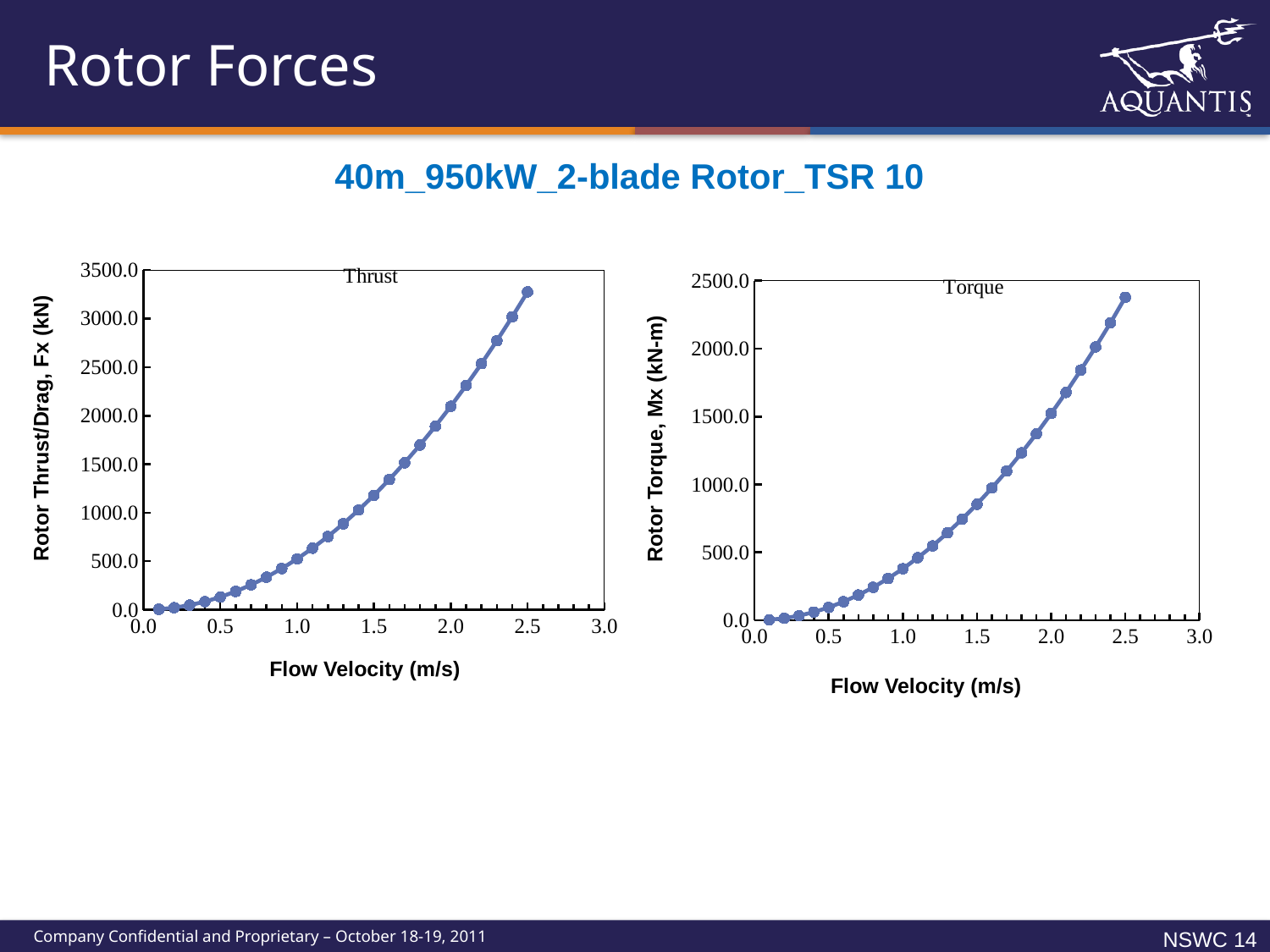
In the Thrust chart, do the values rise or fall as flow velocity increases? rise In the Torque chart, do the values rise or fall as flow velocity increases? rise In the Thrust chart, is the thrust at a flow velocity of 1.5 m/s greater or less than 1000.0? greater What kind of chart is the Torque chart on the right? line chart What is the y-axis label of the Torque chart? Rotor Torque, Mx (kN-m) What is the x-axis label of the Thrust chart? Flow Velocity (m/s) In the Torque chart, is the torque at a flow velocity of 2.5 m/s greater or less than 2000.0? greater In the Torque chart, is the torque at a flow velocity of 1.5 m/s greater or less than 1000.0? less What kind of chart is the Thrust chart on the left? line chart